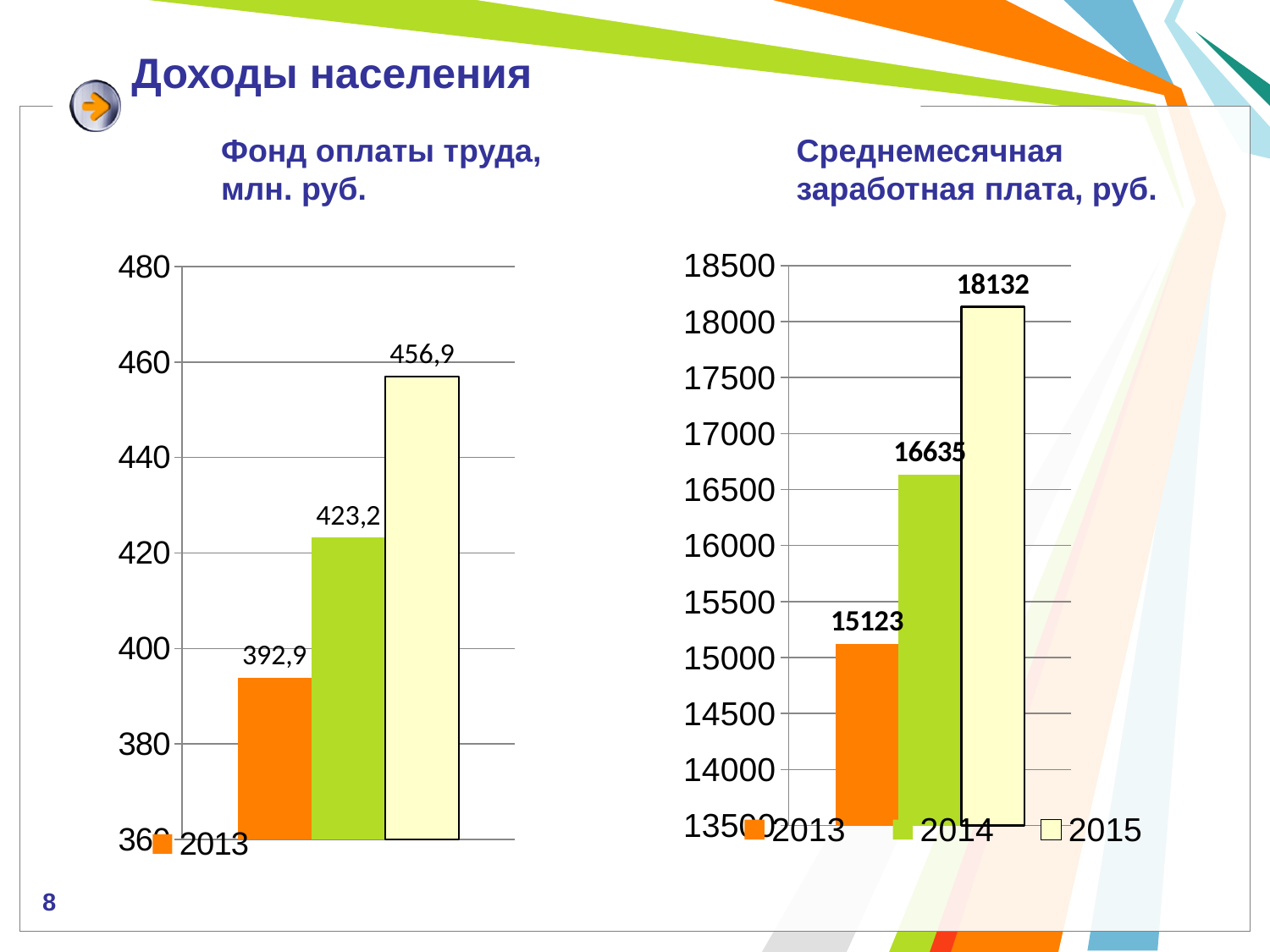
In the chart titled "Среднемесячная заработная плата, руб.", what is the difference between the 2015 and 2013 values? 3009 In the chart titled "Фонд оплаты труда, млн. руб.", what is the value of the green (middle) bar? 423,2 In the chart titled "Фонд оплаты труда, млн. руб.", what is the difference between the tallest bar and the 2013 bar? 64 In the chart titled "Фонд оплаты труда, млн. руб.", how many bars are plotted? 3 In the chart titled "Среднемесячная заработная плата, руб.", how many entries does the legend list? 3 In the chart titled "Фонд оплаты труда, млн. руб.", what is the value of the tallest bar? 456,9 In the chart titled "Среднемесячная заработная плата, руб.", what is the value for 2014? 16635 In the chart titled "Среднемесячная заработная плата, руб.", which year has the lowest value? 2013 In the chart titled "Среднемесячная заработная плата, руб.", which year has the highest value? 2015 In the chart titled "Среднемесячная заработная плата, руб.", what is the value for 2013? 15123 In the chart titled "Среднемесячная заработная плата, руб.", do the values rise or fall from 2013 to 2015? rise In the chart titled "Фонд оплаты труда, млн. руб.", what is the value of the orange bar for 2013? 392,9